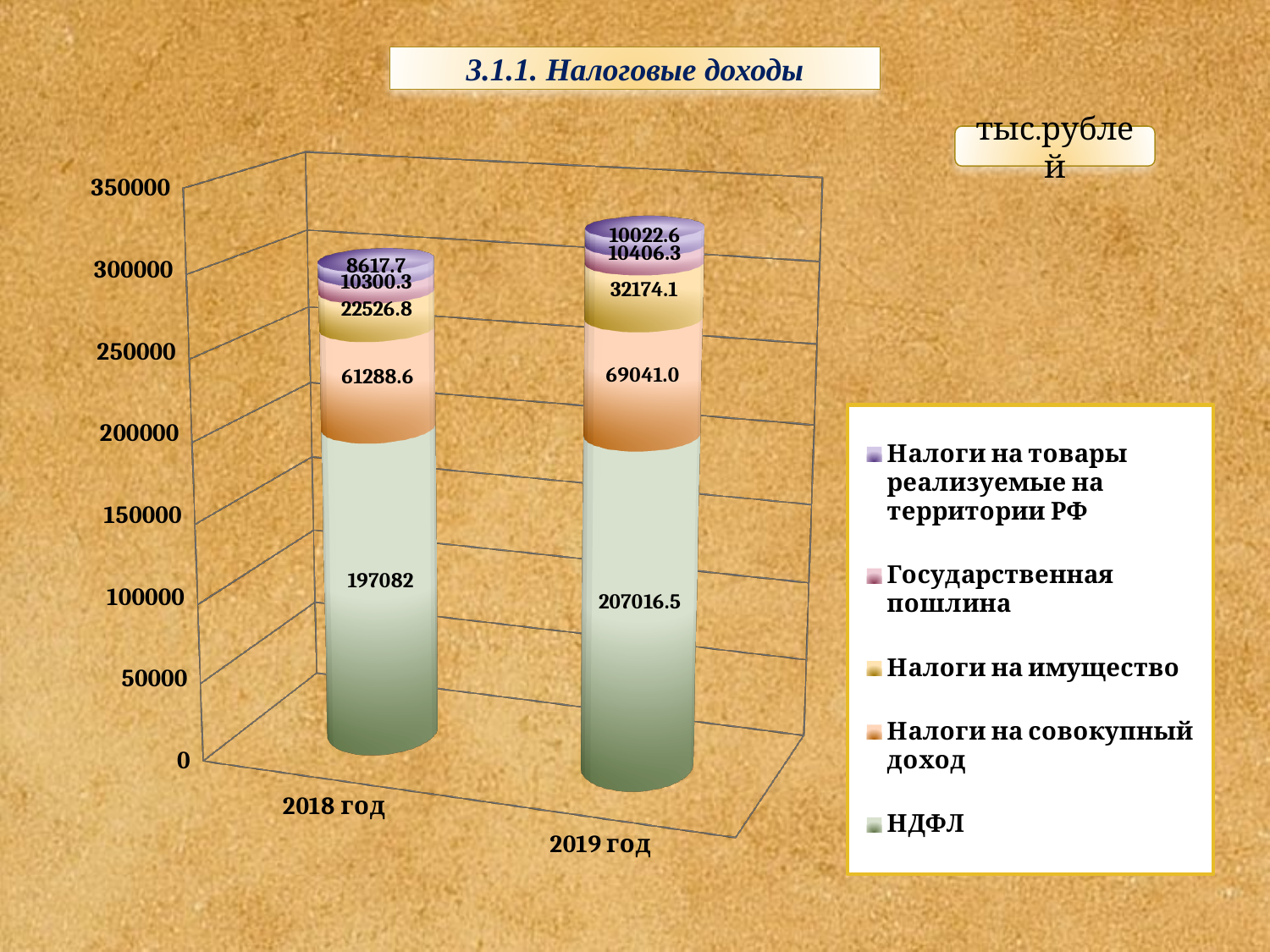
What is the total of the stacked bar for 2018 год? 299815.4 What is the value of НДФЛ for 2019 год? 207016.5 What is the value of НДФЛ for 2018 год? 197082 What kind of chart is shown on the slide? stacked bar chart What is the value of Налоги на имущество for 2019 год? 32174.1 What is the value of Налоги на товары реализуемые на территории РФ for 2019 год? 10022.6 Which series has the smallest value in 2018 год? Налоги на товары реализуемые на территории РФ How many series does the legend list? 5 What is the value of Государственная пошлина for 2018 год? 10300.3 By how much did Налоги на совокупный доход change from 2018 год to 2019 год? 7752.4 Which series has the largest value in 2019 год? НДФЛ How many categories (years) are shown on the x axis? 2